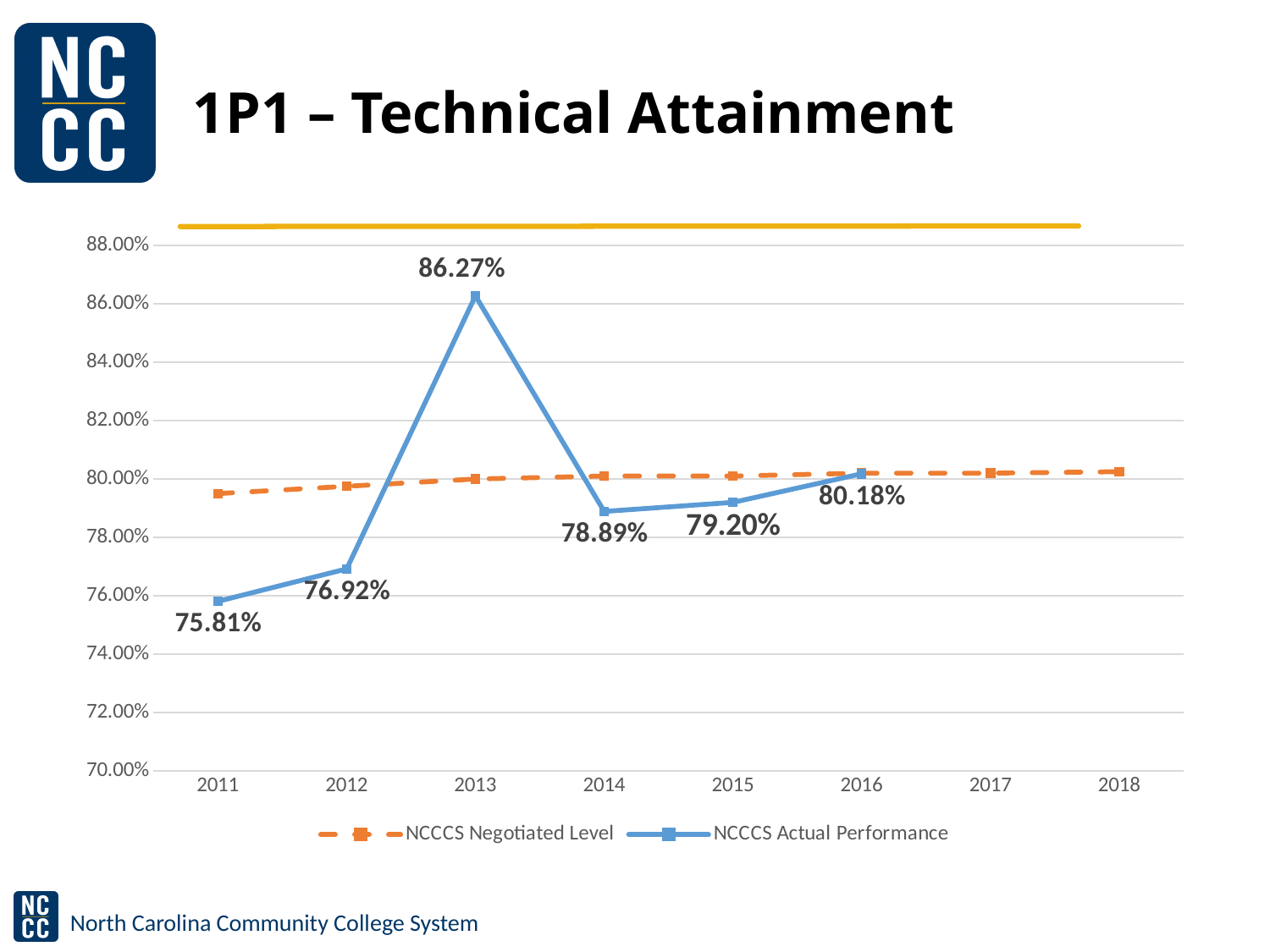
In which year was NCCCS Actual Performance lowest? 2011 Which is larger, NCCCS Actual Performance in 2015 or in 2016? 2016 Is the NCCCS Negotiated Level for 2011 greater or less than 80.00%? less What is the NCCCS Actual Performance value for 2011? 75.81% What is the NCCCS Actual Performance value for 2013? 86.27% What is the NCCCS Actual Performance value for 2016? 80.18% How many years are shown on the x axis? 8 What is the difference between NCCCS Actual Performance in 2013 and 2014? 7.38% Does NCCCS Actual Performance rise or fall from 2014 to 2016? rise What kind of chart is shown on the slide? line chart How many series does the legend list? 2 In which year was NCCCS Actual Performance highest? 2013